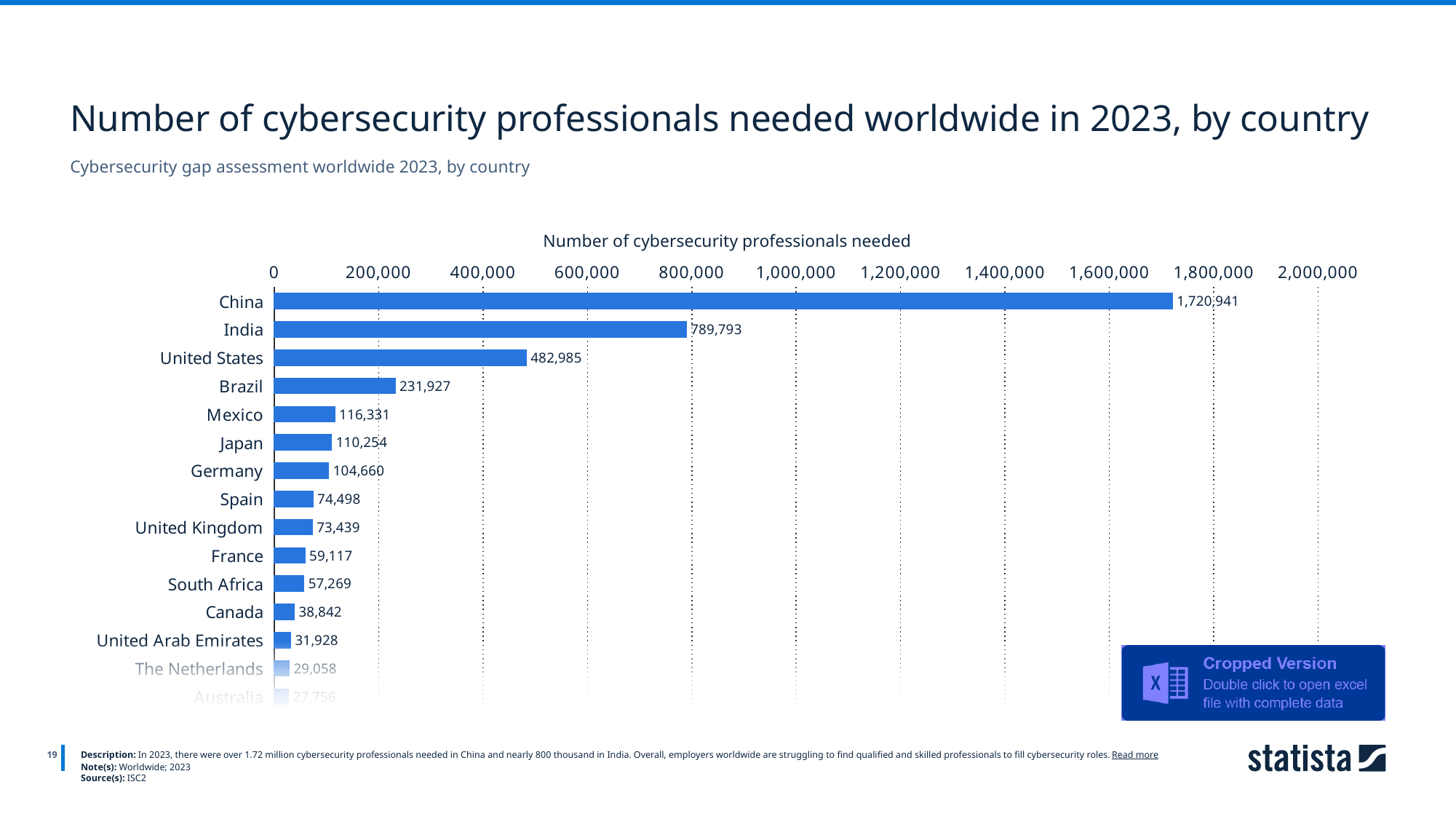
What is the title of the chart's axis shown above the bars? Number of cybersecurity professionals needed What is the difference between the values for the United States and Brazil? 251,058 What kind of chart is shown on the slide? Bar chart What is the value shown for Germany? 104,660 What is the difference between the values for China and India? 931,148 What is the number of cybersecurity professionals needed in China? 1,720,941 Which has a larger value, France or South Africa? France Which has a larger value, Mexico or Japan? Mexico What is the number of cybersecurity professionals needed in India? 789,793 What is the value shown for Canada? 38,842 Is the value for the United States greater or less than 400,000? greater Which country has the highest number of cybersecurity professionals needed? China